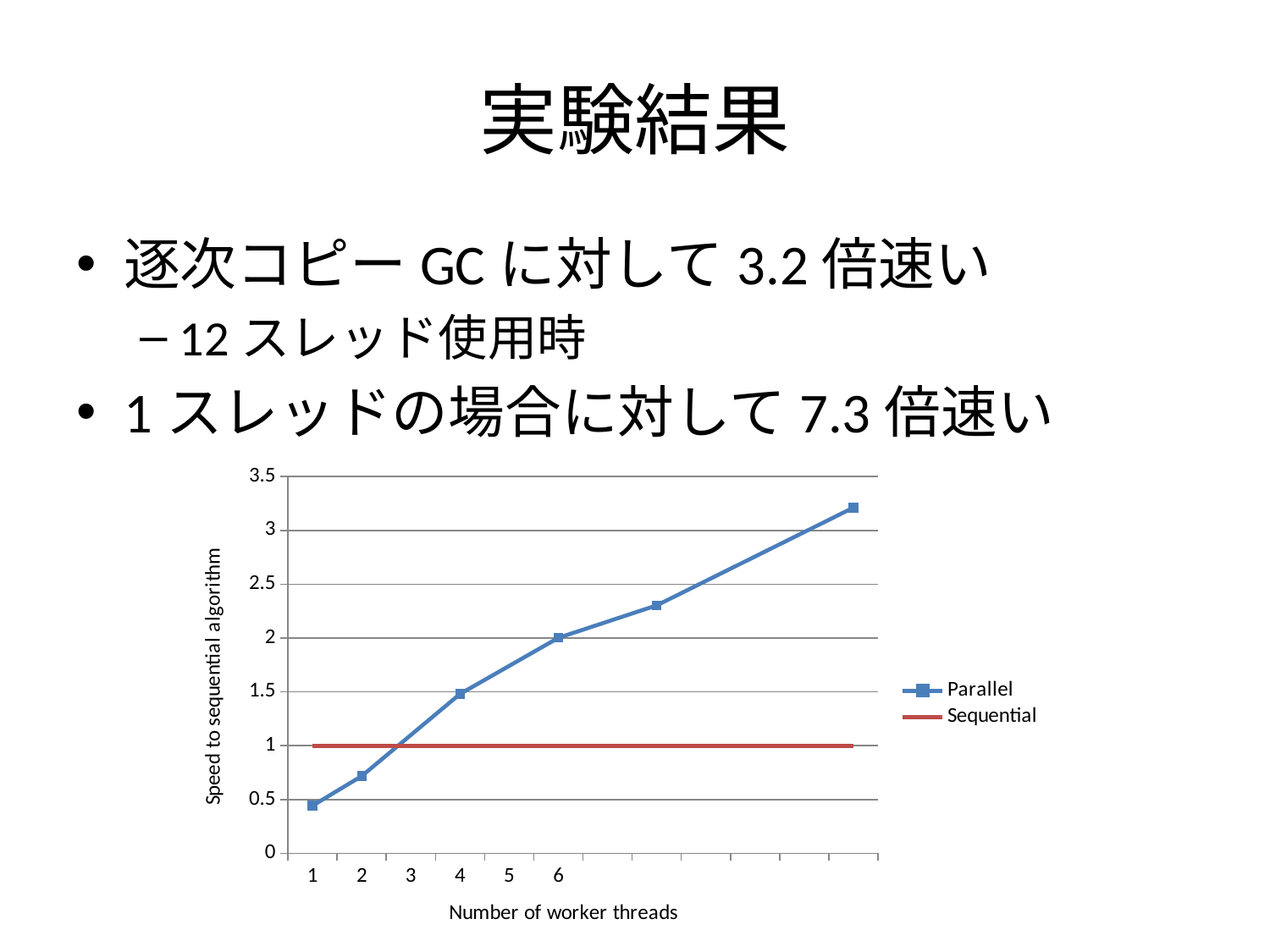
Does the Parallel series rise or fall as the number of worker threads increases? rises What kind of chart is shown on the slide? line chart How many series does the chart legend list? 2 Is the Parallel value at the rightmost data point greater or less than 3? greater Is the Parallel value at 2 worker threads greater or less than 1? less Is the Parallel value at 1 worker thread greater or less than 1? less What is the title of the chart's x axis? Number of worker threads What are the two series named in the chart legend? Parallel and Sequential At 4 worker threads, which series has the larger value, Parallel or Sequential? Parallel At 2 worker threads, which series has the larger value, Parallel or Sequential? Sequential At what value does the Sequential line stay across all worker thread counts? 1